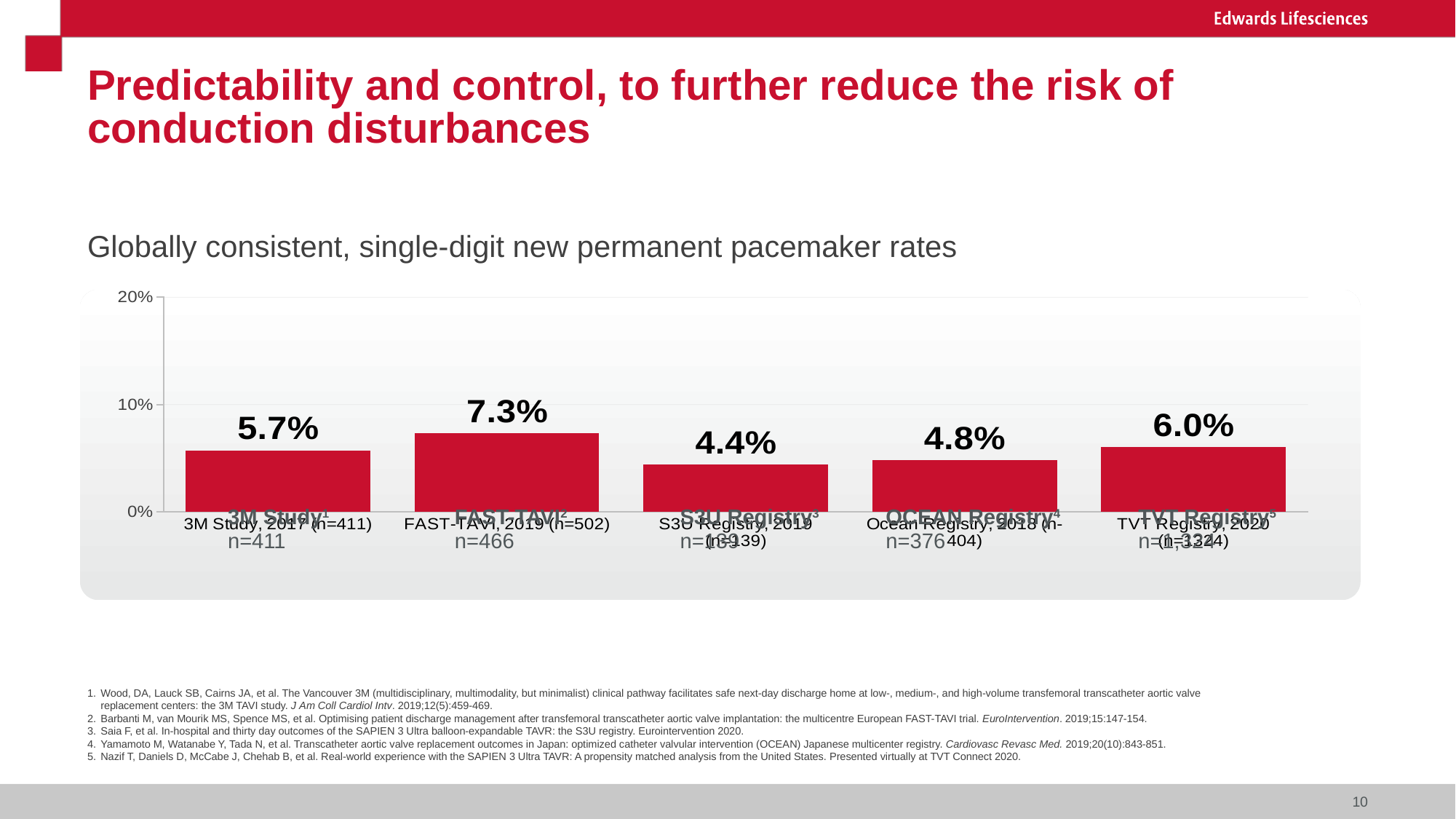
What kind of chart is shown on the slide? Bar chart What is the difference between the FAST-TAVI rate and the S3U Registry rate? 2.9% What value is shown for the S3U Registry? 4.4% What value is shown for the OCEAN Registry? 4.8% What value is shown for FAST-TAVI? 7.3% Which study has the lowest new permanent pacemaker rate? S3U Registry Is the value for FAST-TAVI greater or less than 10%? less Which study has the highest new permanent pacemaker rate? FAST-TAVI What is the new permanent pacemaker rate shown for the 3M Study? 5.7% Which is larger, the rate for the 3M Study or the rate for the TVT Registry? TVT Registry What value is shown for the TVT Registry? 6.0% How many studies are plotted in the chart? 5